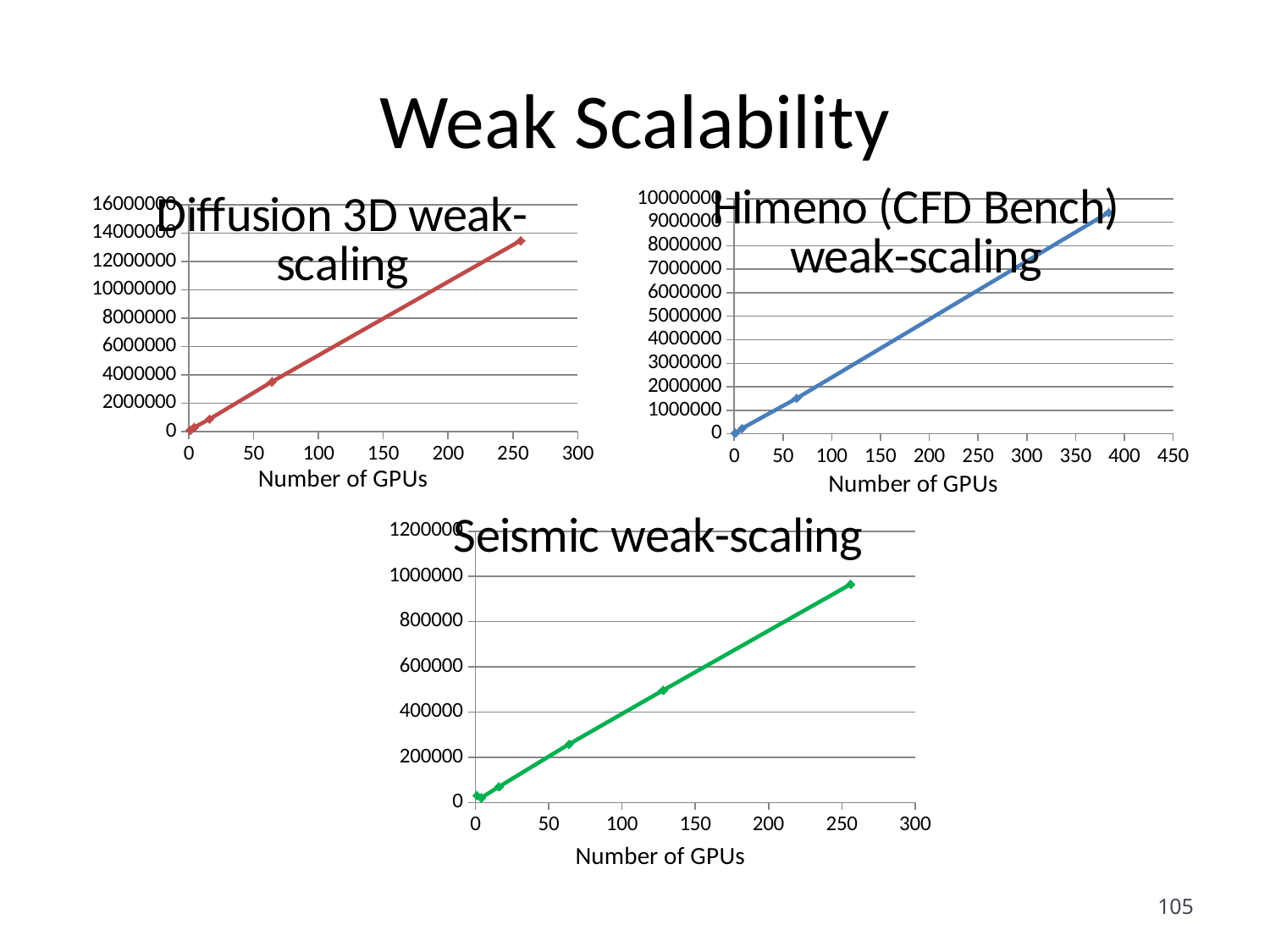
What is the x-axis label of the "Seismic weak-scaling" chart? Number of GPUs In the "Seismic weak-scaling" chart, is the value at the rightmost point (about 256 GPUs) greater or less than 800000? greater In the "Himeno (CFD Bench) weak-scaling" chart, is the value at about 64 GPUs greater or less than 2000000? less In the "Seismic weak-scaling" chart, do the values rise or fall as the number of GPUs increases? rise What kind of chart is the "Seismic weak-scaling" chart? line chart What colour is the line in the "Himeno (CFD Bench) weak-scaling" chart? blue In the "Himeno (CFD Bench) weak-scaling" chart, is the value at the rightmost point (about 384 GPUs) greater or less than 9000000? greater In the "Himeno (CFD Bench) weak-scaling" chart, do the values rise or fall along the x axis? rise How many charts are shown on the slide? 3 In the "Diffusion 3D weak-scaling" chart, do the values rise or fall as the number of GPUs increases? rise